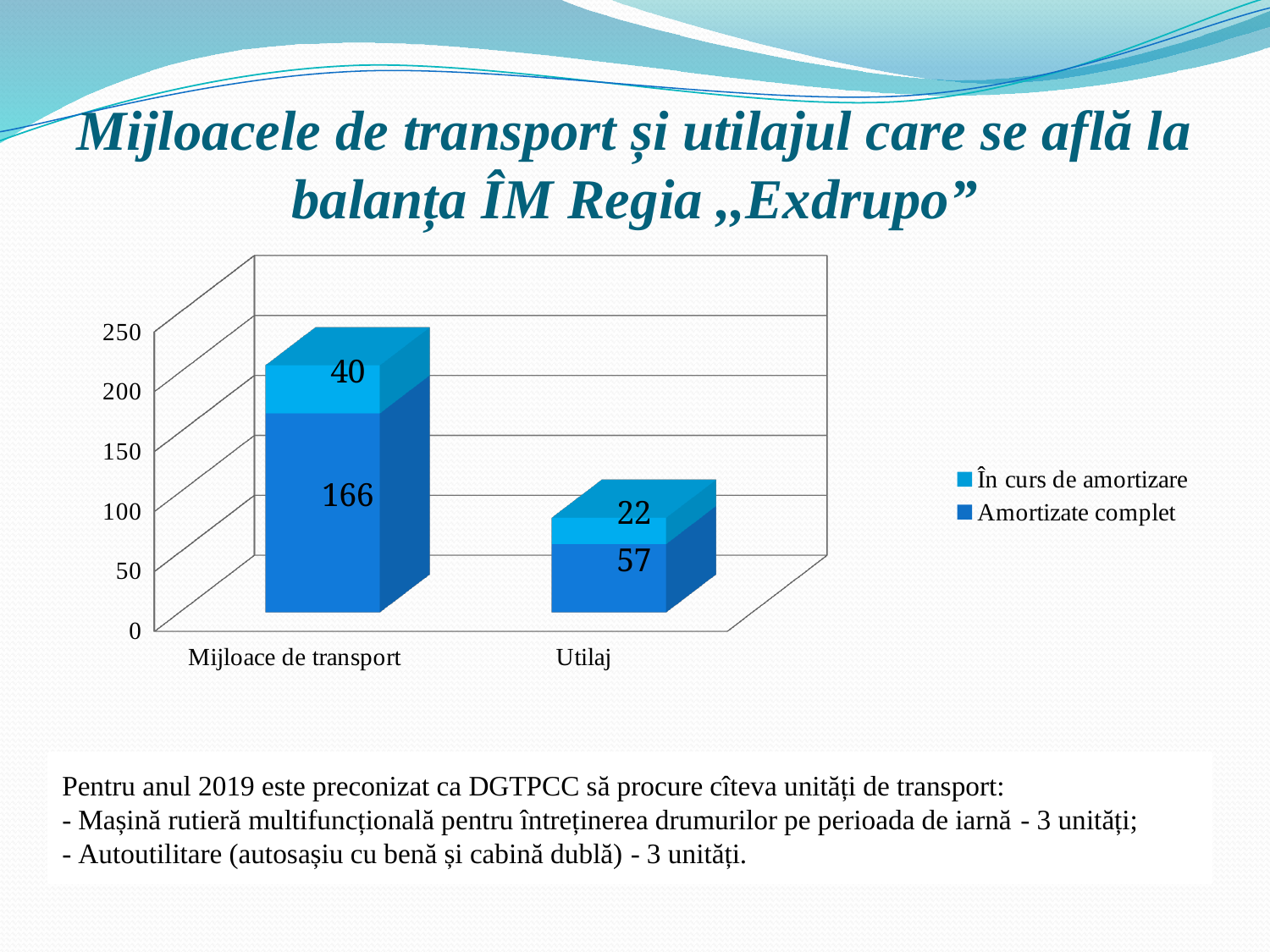
What is the value for "În curs de amortizare" in the "Mijloace de transport" category? 40 Which category has the higher "Amortizate complet" value, "Mijloace de transport" or "Utilaj"? Mijloace de transport Which category has the lowest "În curs de amortizare" value? Utilaj What is the value for "În curs de amortizare" in the "Utilaj" category? 22 What kind of chart is shown on the slide? Stacked bar chart How many categories are shown on the x axis? 2 What is the difference between the "Amortizate complet" values for "Mijloace de transport" and "Utilaj"? 109 How many series does the legend list? 2 What is the value for "Amortizate complet" in the "Utilaj" category? 57 What is the total of the stacked bar for "Mijloace de transport"? 206 What is the total of the stacked bar for "Utilaj"? 79 What is the value for "Amortizate complet" in the "Mijloace de transport" category? 166